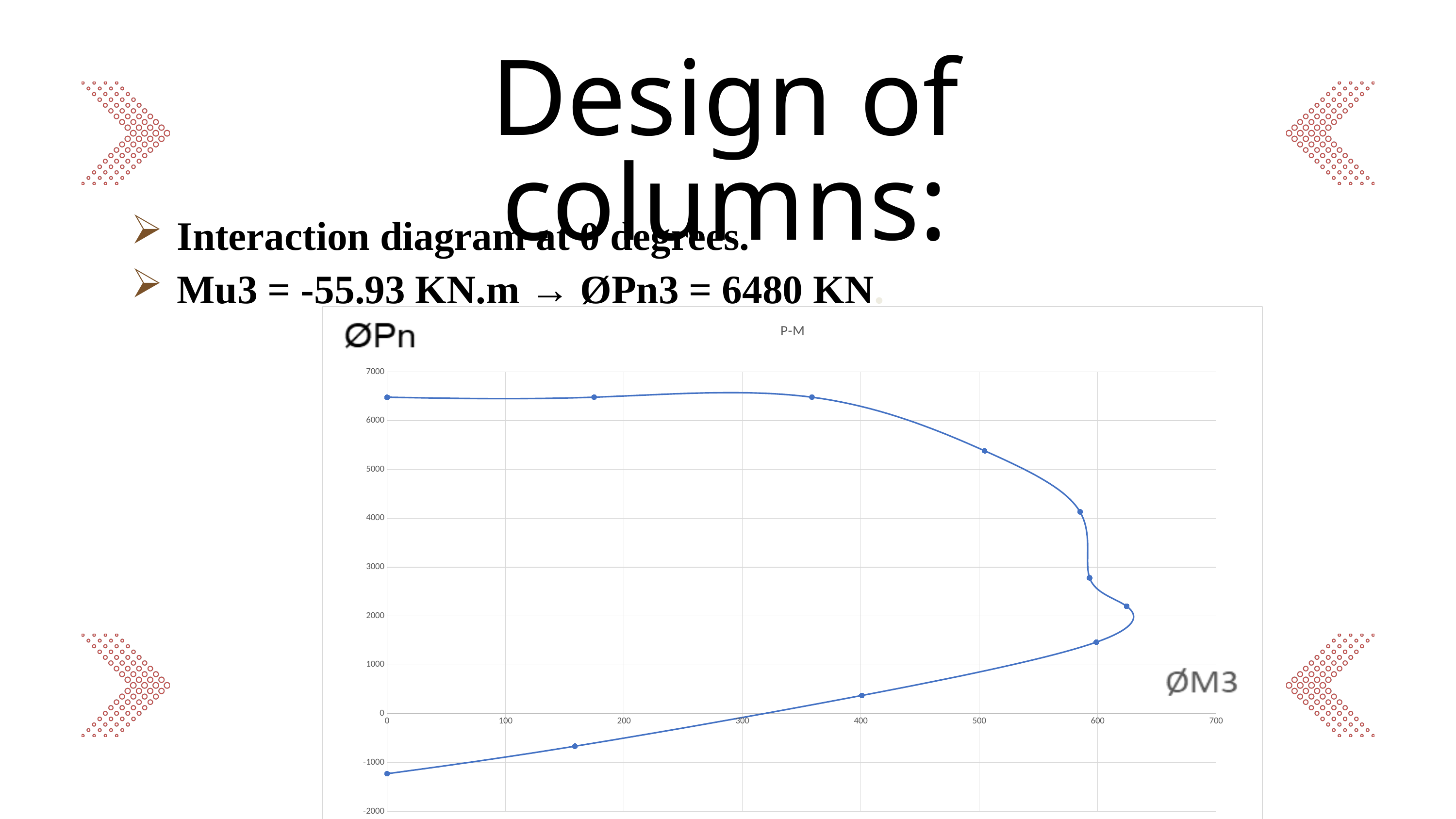
Is the ØPn value of the lowest point on the curve greater or less than -1000? less What kind of chart is shown on the slide? line chart What is the title of the chart? P-M Is the ØPn value of the point near ØM3 = 400 greater or less than 1000? less Is the ØPn value of the point at ØM3 = 0 at the top of the curve greater or less than 6000? greater How many data points are marked on the curve? 11 What is the highest tick value shown on the vertical axis? 7000 At what ØM3 value does the lowest point of the curve occur? 0 Which point has the larger ØPn value: the point near ØM3 = 500 or the point near ØM3 = 400? the point near ØM3 = 500 What label is shown on the vertical axis of the chart? ØPn